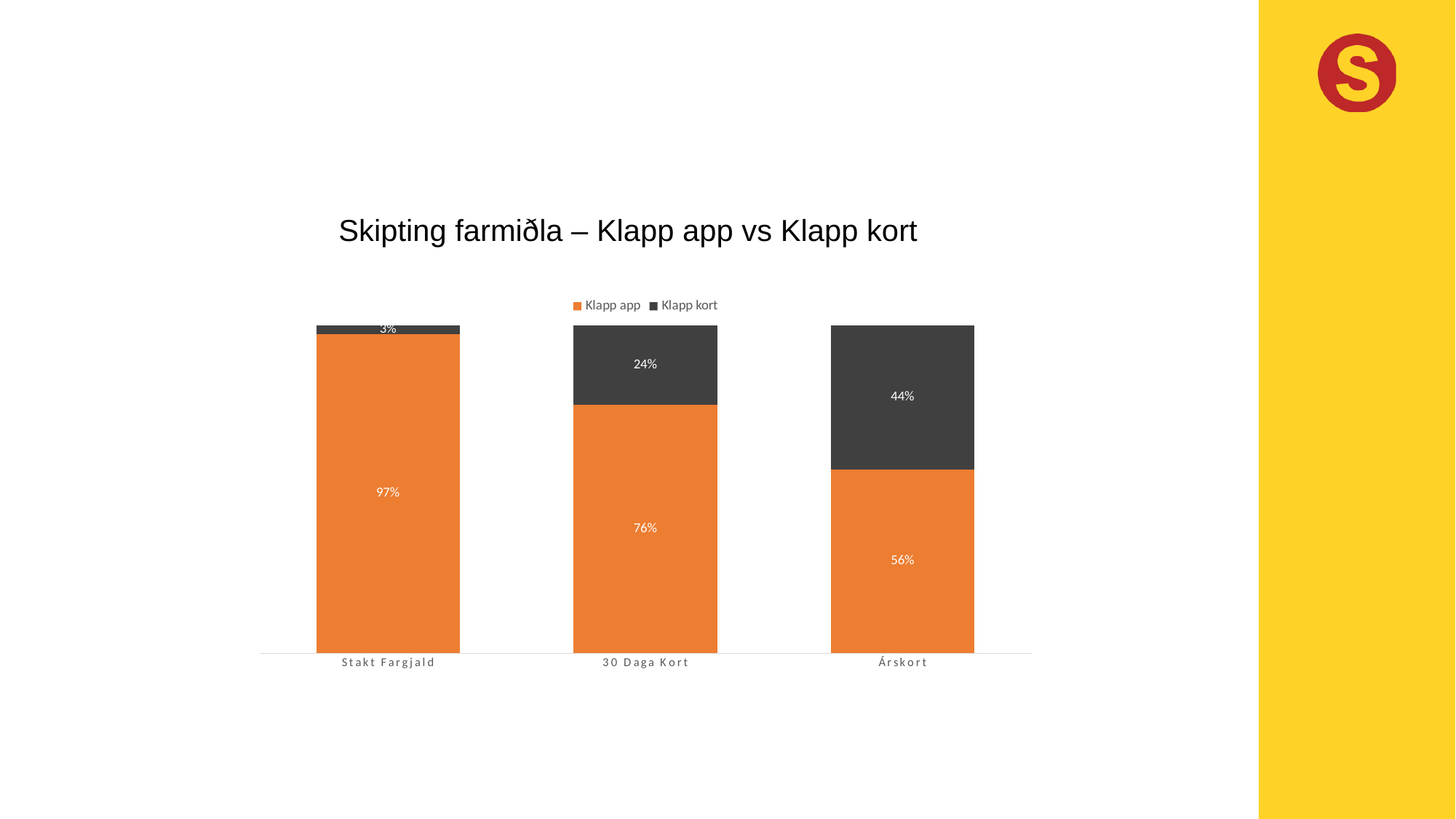
What is the Klapp app value for Stakt Fargjald? 97% How many series does the legend list? 2 Which category has the highest Klapp kort share? Árskort What is the difference between the Klapp app values for Stakt Fargjald and 30 Daga Kort? 21% Does the Klapp app share rise or fall from Stakt Fargjald to Árskort? Fall What kind of chart is shown on the slide? Stacked bar chart Is the Klapp app value larger for 30 Daga Kort or for Árskort? 30 Daga Kort What is the Klapp kort value for 30 Daga Kort? 24% What is the Klapp kort value for Stakt Fargjald? 3% How many categories are shown on the x axis? 3 What is the Klapp app value for Árskort? 56% Which category has the lowest Klapp app share? Árskort